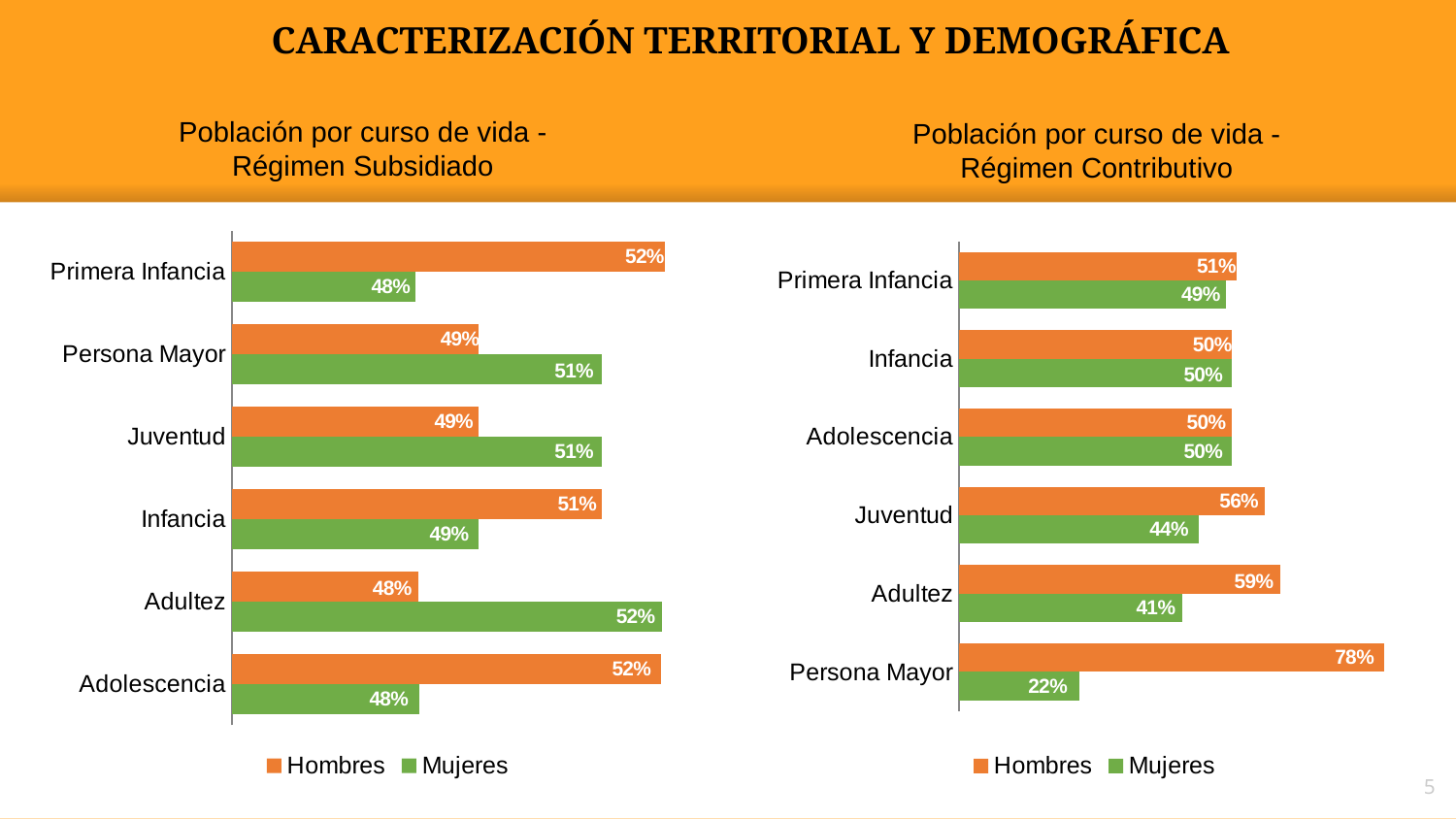
In the 'Población por curso de vida - Régimen Contributivo' chart, what is the value for Mujeres in Juventud? 44% In the 'Población por curso de vida - Régimen Contributivo' chart, which colour represents Mujeres? Green How many series does the legend of the 'Población por curso de vida - Régimen Contributivo' chart list? 2 In the 'Población por curso de vida - Régimen Subsidiado' chart, what is the value for Mujeres in Adultez? 52% In the 'Población por curso de vida - Régimen Contributivo' chart, what is the difference between Hombres and Mujeres in Adultez? 18% In the 'Población por curso de vida - Régimen Subsidiado' chart, which is larger for Persona Mayor, Hombres or Mujeres? Mujeres In the 'Población por curso de vida - Régimen Contributivo' chart, which category has the highest Hombres value? Persona Mayor In the 'Población por curso de vida - Régimen Contributivo' chart, what is the value for Hombres in Persona Mayor? 78% What kind of chart is the 'Población por curso de vida - Régimen Subsidiado' chart? Bar chart In the 'Población por curso de vida - Régimen Subsidiado' chart, what is the value for Hombres in Primera Infancia? 52% How many categories are shown in the 'Población por curso de vida - Régimen Subsidiado' chart? 6 In the 'Población por curso de vida - Régimen Contributivo' chart, which category has the lowest Mujeres value? Persona Mayor